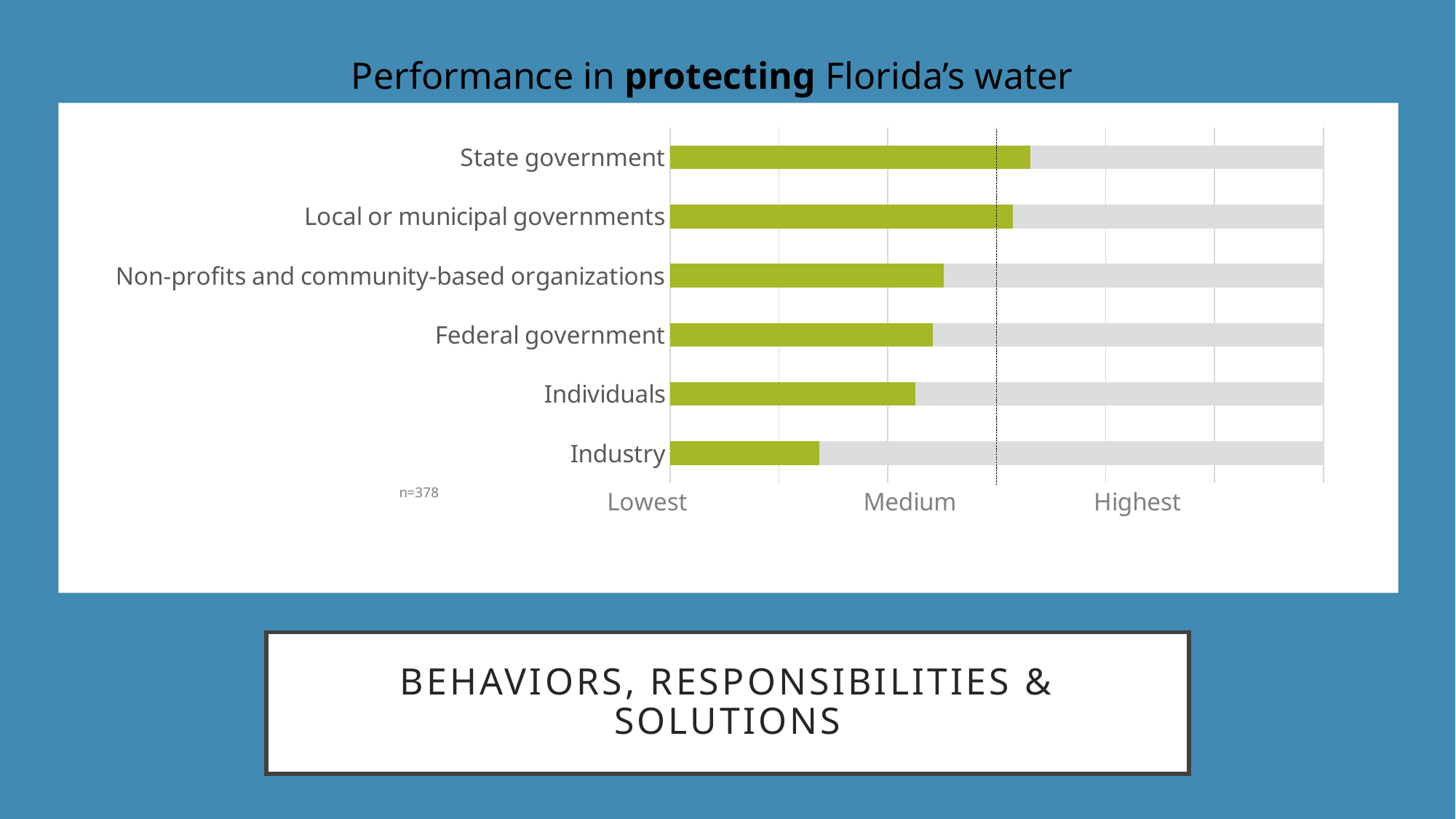
Which is rated higher: Individuals or Industry? Individuals What kind of chart is shown on the slide? Bar chart What is the title of the chart? Performance in protecting Florida's water Which is rated higher: State government or Industry? State government How many categories are plotted in the chart? 6 Which is rated higher: Local or municipal governments or Non-profits and community-based organizations? Local or municipal governments What sample size (n) is noted on the chart? n=378 Which category has the lowest rated performance in protecting Florida's water? Industry Is the bar for State government above or below the Medium mark on the axis? Above Is the bar for Industry above or below the Medium mark on the axis? Below Which category has the highest rated performance in protecting Florida's water? State government